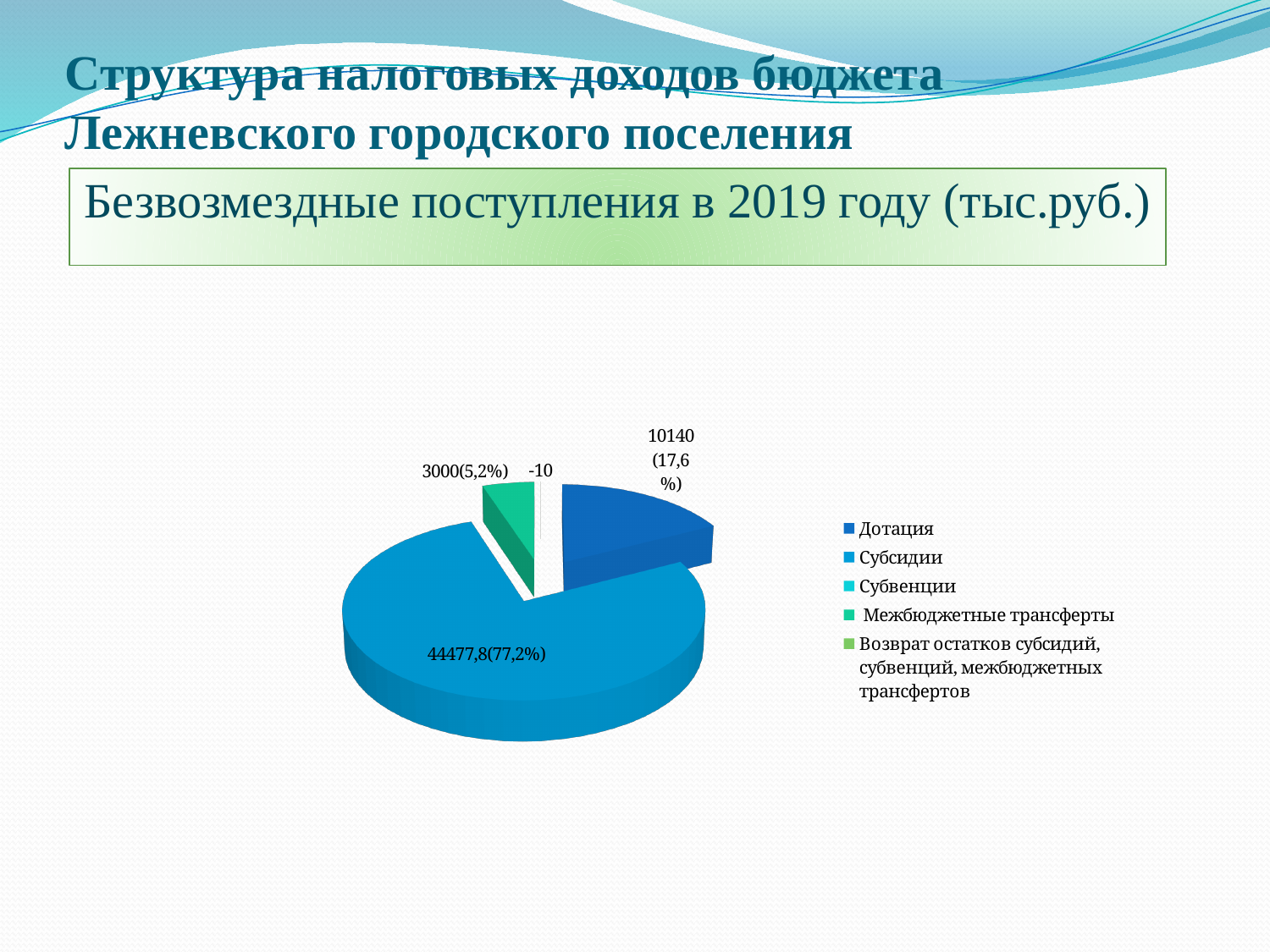
What percentage share is shown next to the value 3000? 5,2% How many entries does the chart legend list? 5 What is the title shown above the chart? Безвозмездные поступления в 2019 году (тыс.руб.) What is the difference between the values for Субсидии and Дотация? 34337,8 What is the value shown for Дотация? 10140 Which is larger, Дотация or Субсидии? Субсидии Which category has the largest slice of the pie? Субсидии What share of the pie does Дотация account for? 17,6% What kind of chart is shown on the slide? pie chart What negative value is labeled on the chart? -10 What is the value shown for Субсидии? 44477,8 What share of the pie does Субсидии account for? 77,2%